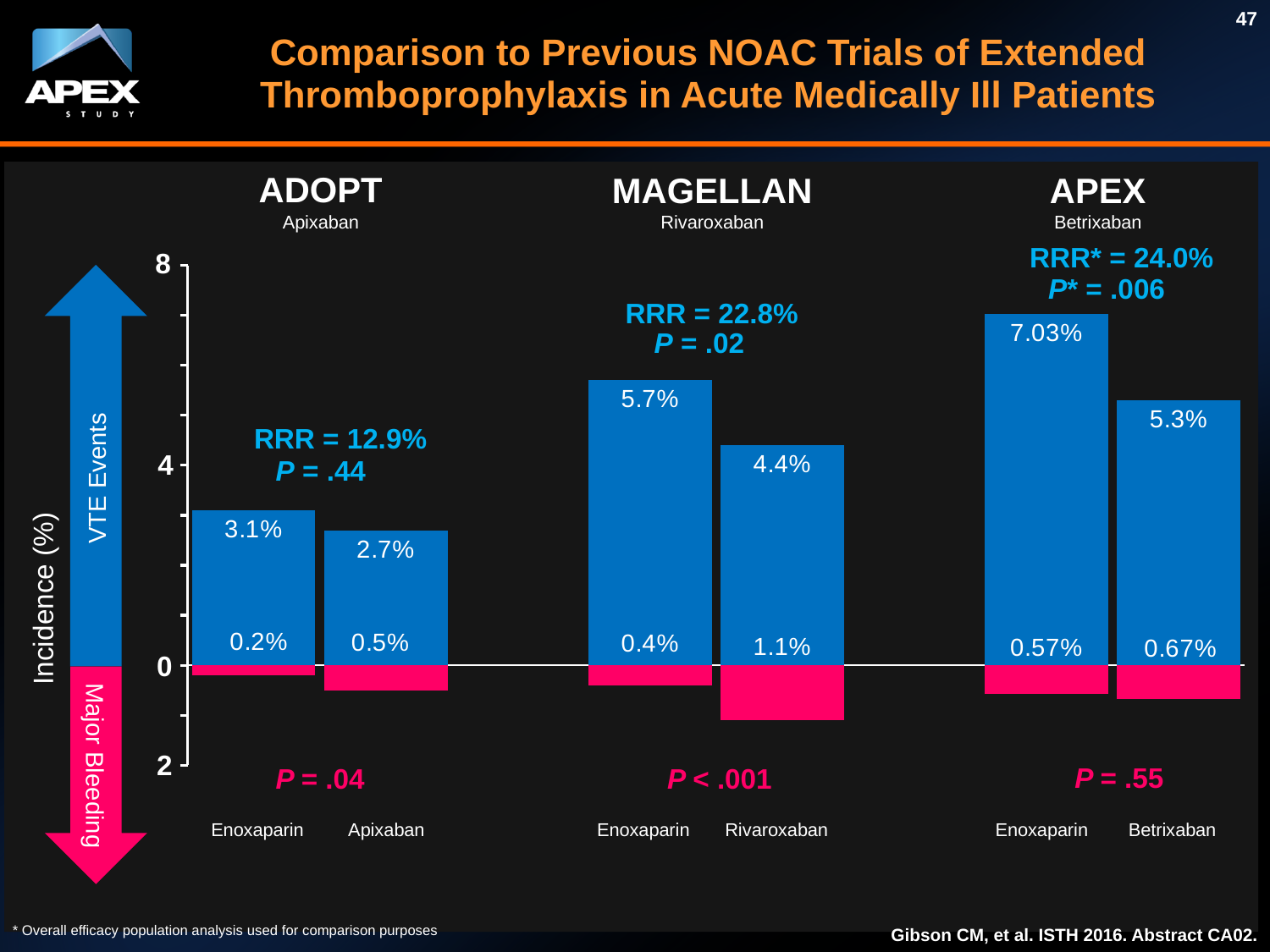
What is the major bleeding rate for Betrixaban in the APEX trial? 0.67% Which bar has the highest VTE event rate on the chart? Enoxaparin in APEX (7.03%) What is the major bleeding rate for Apixaban in the ADOPT trial? 0.5% What is the VTE event rate for Enoxaparin in the APEX trial? 7.03% How many treatment arms (bars) are shown for VTE events across all three trials? 6 What is the VTE event rate for Rivaroxaban in the MAGELLAN trial? 4.4% What is the difference in VTE event rate between Enoxaparin and Rivaroxaban in the MAGELLAN trial? 1.3% Is the VTE event rate for Betrixaban in the APEX trial greater or less than 4? greater What does the pink (downward) portion of the bars represent? Major Bleeding Which has a higher major bleeding rate in the MAGELLAN trial, Enoxaparin or Rivaroxaban? Rivaroxaban Which bar has the lowest major bleeding rate on the chart? Enoxaparin in ADOPT (0.2%) What kind of chart is shown on the slide? Bar chart